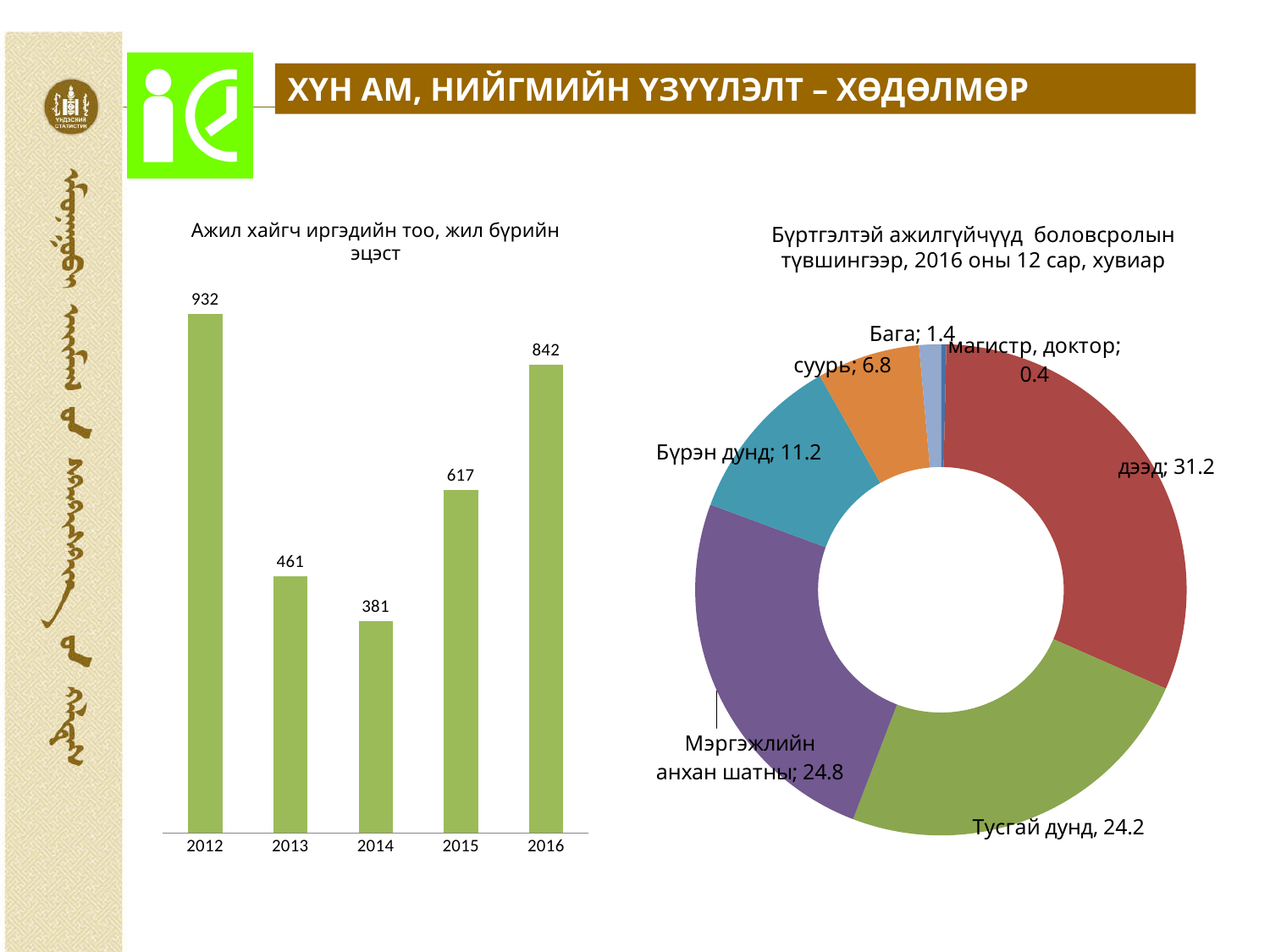
In the left chart (Ажил хайгч иргэдийн тоо), how many years are shown on the x axis? 5 In the left chart (Ажил хайгч иргэдийн тоо), what is the value for 2012? 932 In the right chart (Бүртгэлтэй ажилгүйчүүд боловсролын түвшингээр), what is the value for дээд? 31.2 In the left chart (Ажил хайгч иргэдийн тоо), which year has the highest value? 2012 What kind of chart is the right chart (Бүртгэлтэй ажилгүйчүүд боловсролын түвшингээр)? doughnut chart In the left chart (Ажил хайгч иргэдийн тоо), which is larger, the value for 2013 or the value for 2015? 2015 In the left chart (Ажил хайгч иргэдийн тоо), which year has the lowest value? 2014 What kind of chart is the left chart (Ажил хайгч иргэдийн тоо)? bar chart In the right chart (Бүртгэлтэй ажилгүйчүүд боловсролын түвшингээр), how many categories are shown? 7 In the left chart (Ажил хайгч иргэдийн тоо), what is the value for 2014? 381 In the right chart (Бүртгэлтэй ажилгүйчүүд боловсролын түвшингээр), which category has the smallest share? магистр, доктор In the left chart (Ажил хайгч иргэдийн тоо), what is the difference between the values for 2016 and 2015? 225